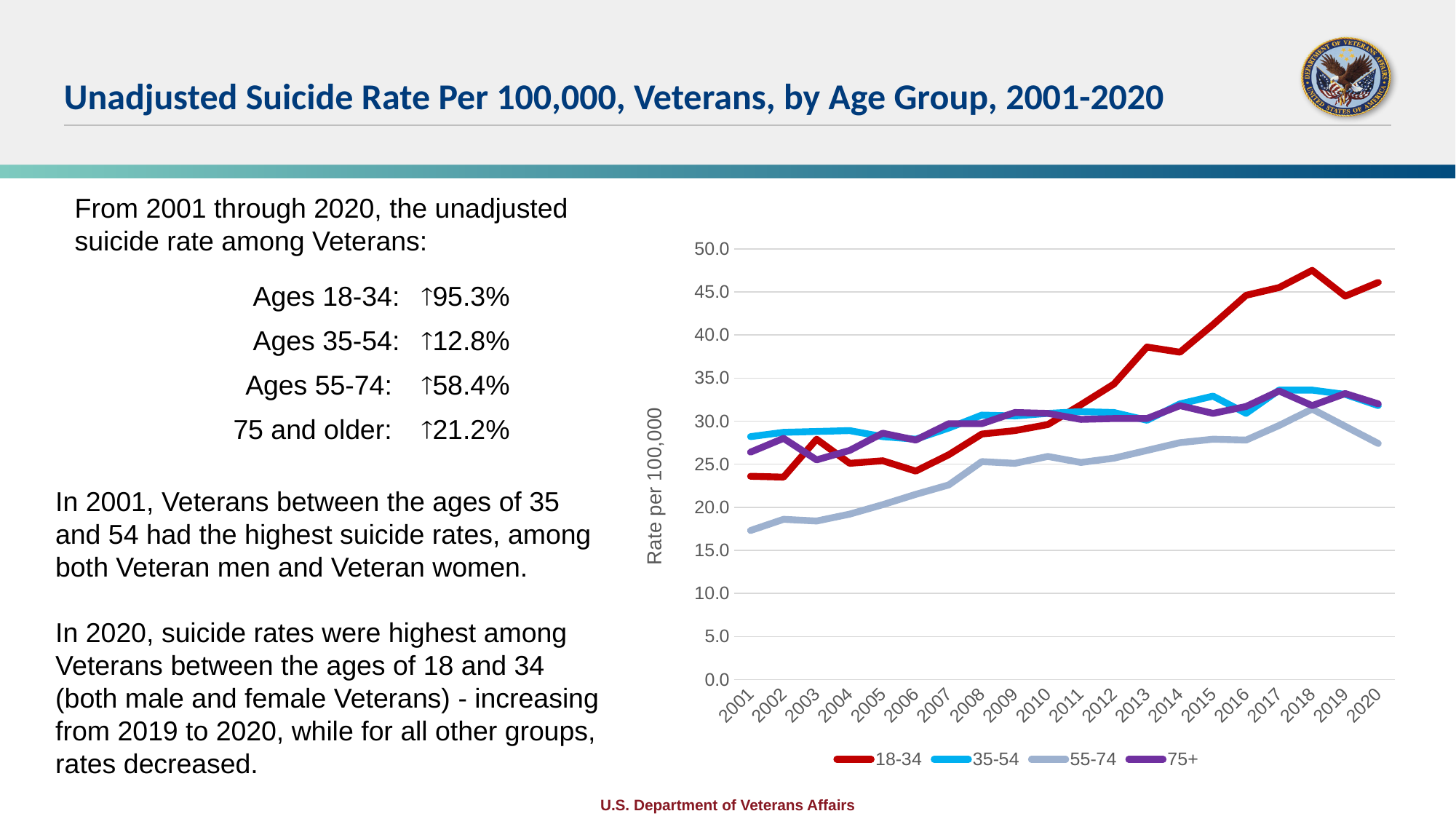
Does the suicide rate for the 18-34 group generally rise or fall from 2001 to 2020? rise What colour is the line for the 18-34 age group? red How many series does the chart legend list? 4 What is the label on the y axis of the chart? Rate per 100,000 Which age group has the highest suicide rate in 2020? 18-34 Is the value for the 55-74 group in 2001 greater or less than 20.0? less How many years are plotted along the x axis of the chart? 20 In 2020, which is larger: the rate for the 18-34 group or the rate for the 55-74 group? 18-34 Which age group has the lowest suicide rate in 2001? 55-74 What type of chart is shown on the slide? line chart Is the value for the 18-34 group in 2018 greater or less than 45.0? greater Is the value for the 35-54 group in 2001 greater or less than 25.0? greater